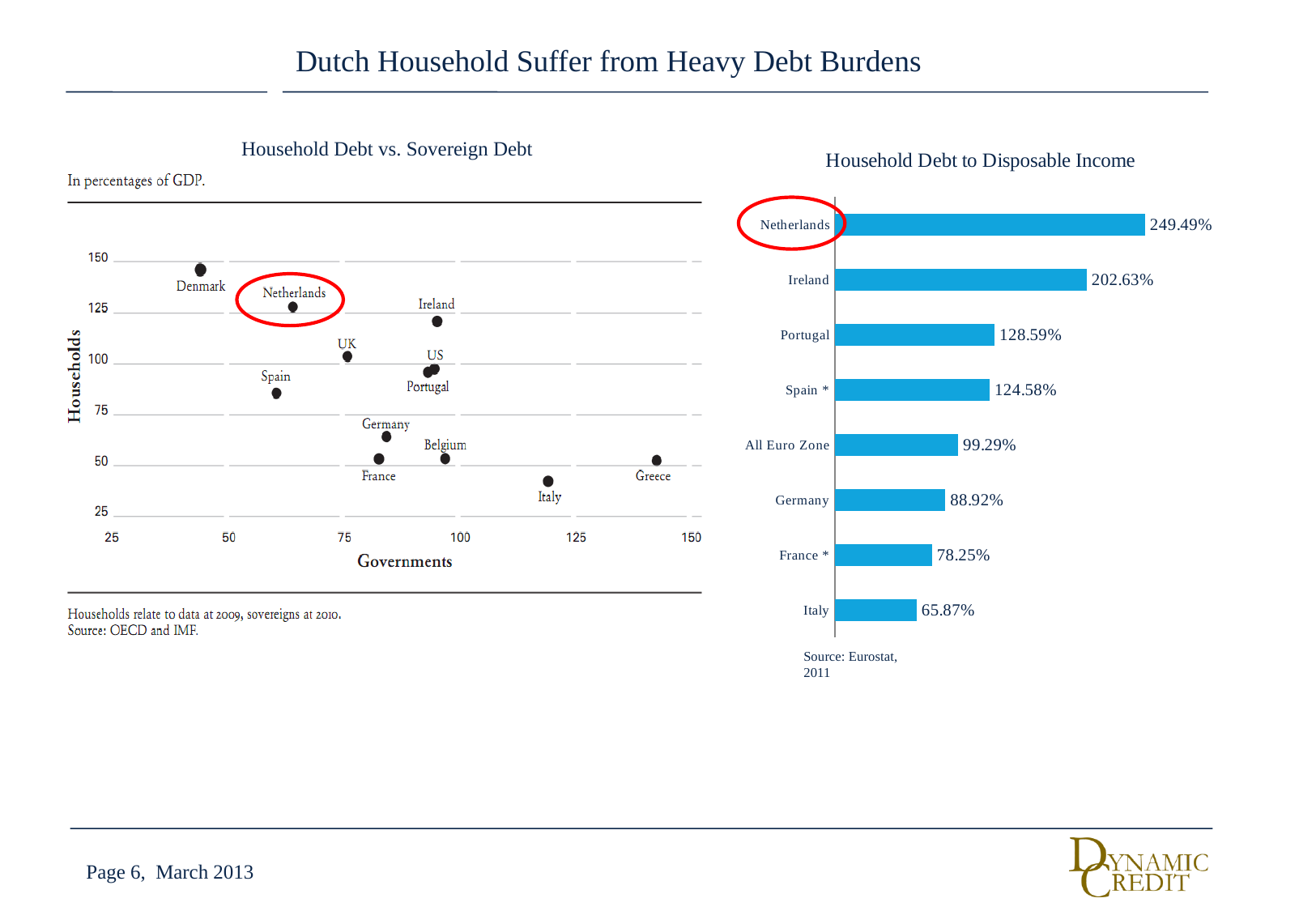
In the 'Household Debt vs. Sovereign Debt' chart, is the government debt value for Greece greater or less than 125? greater In the 'Household Debt to Disposable Income' chart, which is larger, Portugal or Spain? Portugal In the 'Household Debt to Disposable Income' chart, which country has the highest value? Netherlands In the 'Household Debt to Disposable Income' chart, what is the value for the Netherlands? 249.49% In the 'Household Debt to Disposable Income' chart, what is the difference between the Netherlands and Ireland? 46.86% In the 'Household Debt vs. Sovereign Debt' chart, is the household debt value for Denmark greater or less than 125? greater How many categories are shown in the 'Household Debt to Disposable Income' chart? 8 What kind of chart is 'Household Debt vs. Sovereign Debt'? Scatter chart What kind of chart is 'Household Debt to Disposable Income'? Bar chart In the 'Household Debt to Disposable Income' chart, which country has the lowest value? Italy In the 'Household Debt to Disposable Income' chart, what is the value for Germany? 88.92% In the 'Household Debt vs. Sovereign Debt' chart, which country is circled in red? Netherlands